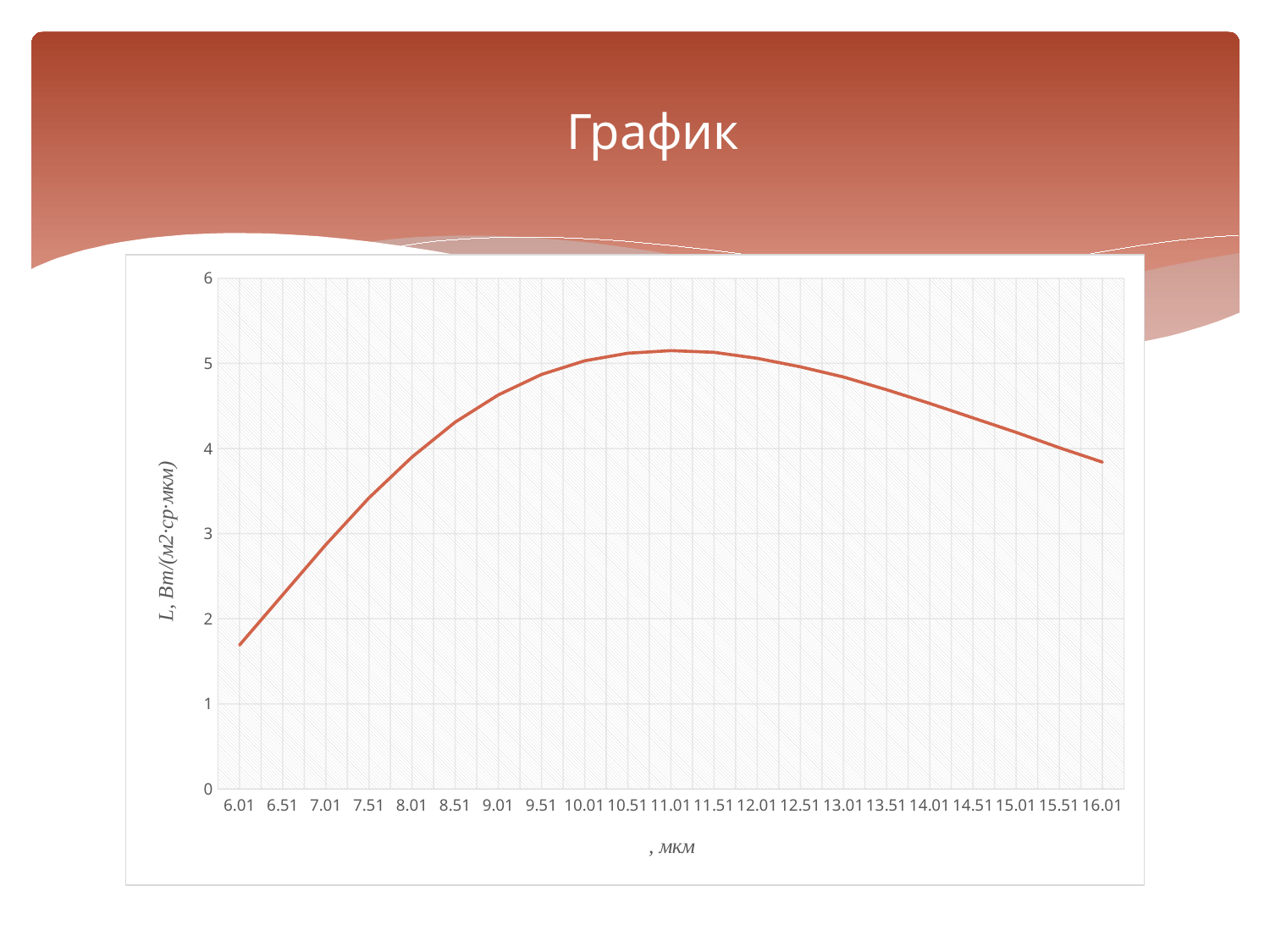
What is the title of the slide containing the chart? График Is the value of L at 6.01 greater or less than 2? less At which x value is the plotted value of L lowest? 6.01 Which has the larger value of L: 6.51 or 16.01? 16.01 Is the value of L at 7.51 greater or less than 3? greater Does the value of L rise or fall along the x axis from 11.51 to 16.01? fall Which has the larger value of L: 10.01 or 15.01? 10.01 What is the label of the vertical axis of the chart? L, Вт/(м2·ср·мкм) Is the value of L at 16.01 greater or less than 4? less What kind of chart is shown on the slide? line chart How many tick labels are shown along the x axis of the chart? 21